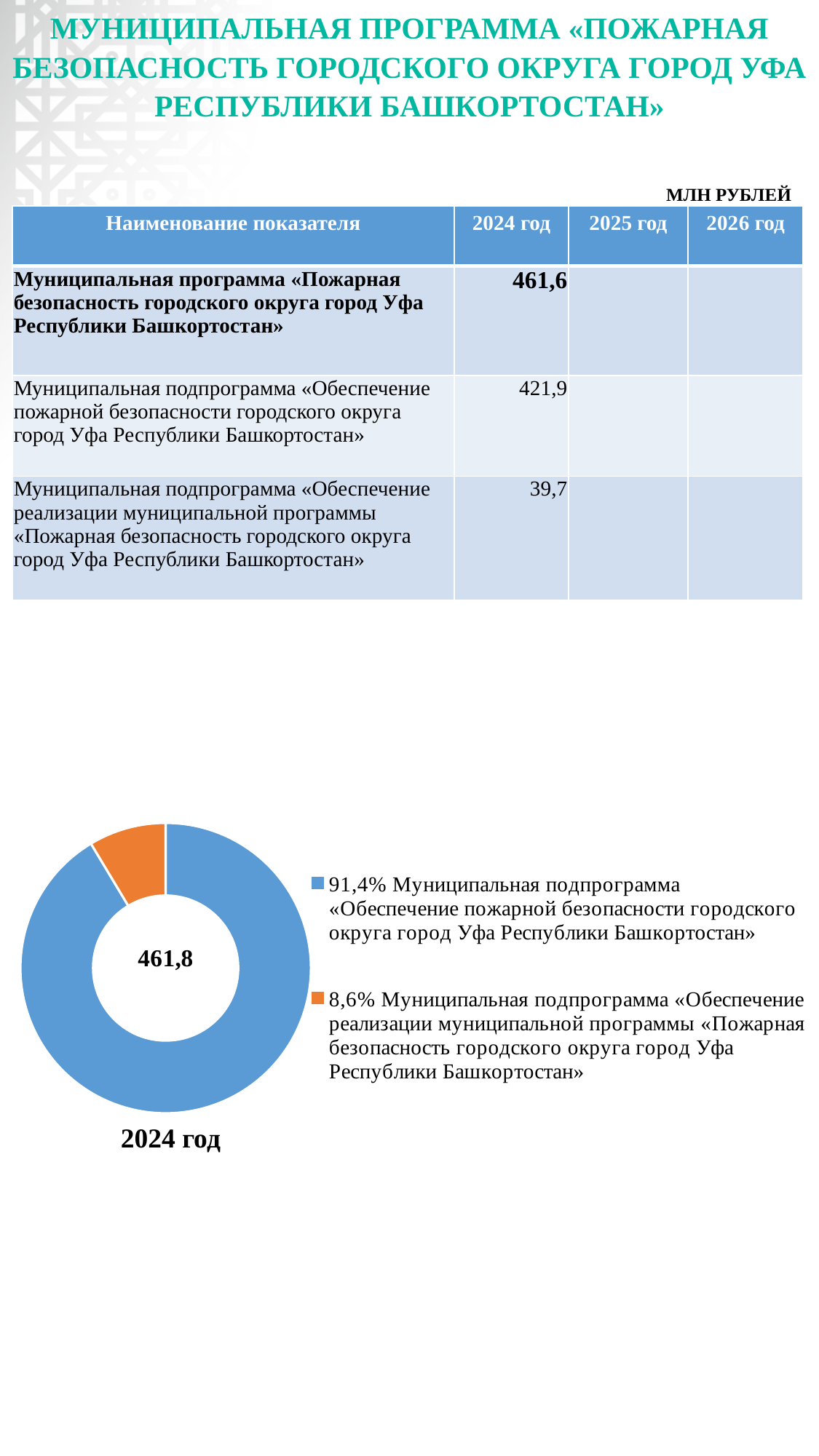
Which slice of the doughnut chart is the largest? Муниципальная подпрограмма «Обеспечение пожарной безопасности городского округа город Уфа Республики Башкортостан» By how many percentage points does the 91,4% slice exceed the 8,6% slice in the doughnut chart? 82,8 What colour is the slice representing 8,6% in the doughnut chart? Orange How many entries does the legend of the doughnut chart list? 2 How many slices does the doughnut chart have? 2 What kind of chart is shown on the slide? Doughnut (pie) chart What value is printed in the centre of the doughnut chart? 461,8 What year label is shown under the doughnut chart? 2024 год What share of the doughnut chart does the subprogram «Обеспечение реализации муниципальной программы «Пожарная безопасность городского округа город Уфа Республики Башкортостан»» take? 8,6% What share of the doughnut chart does the subprogram «Обеспечение пожарной безопасности городского округа город Уфа Республики Башкортостан» take? 91,4% Which is larger in the doughnut chart: the share of the blue slice or the share of the orange slice? The blue slice (91,4%) Which slice of the doughnut chart is the smallest? Муниципальная подпрограмма «Обеспечение реализации муниципальной программы «Пожарная безопасность городского округа город Уфа Республики Башкортостан»»